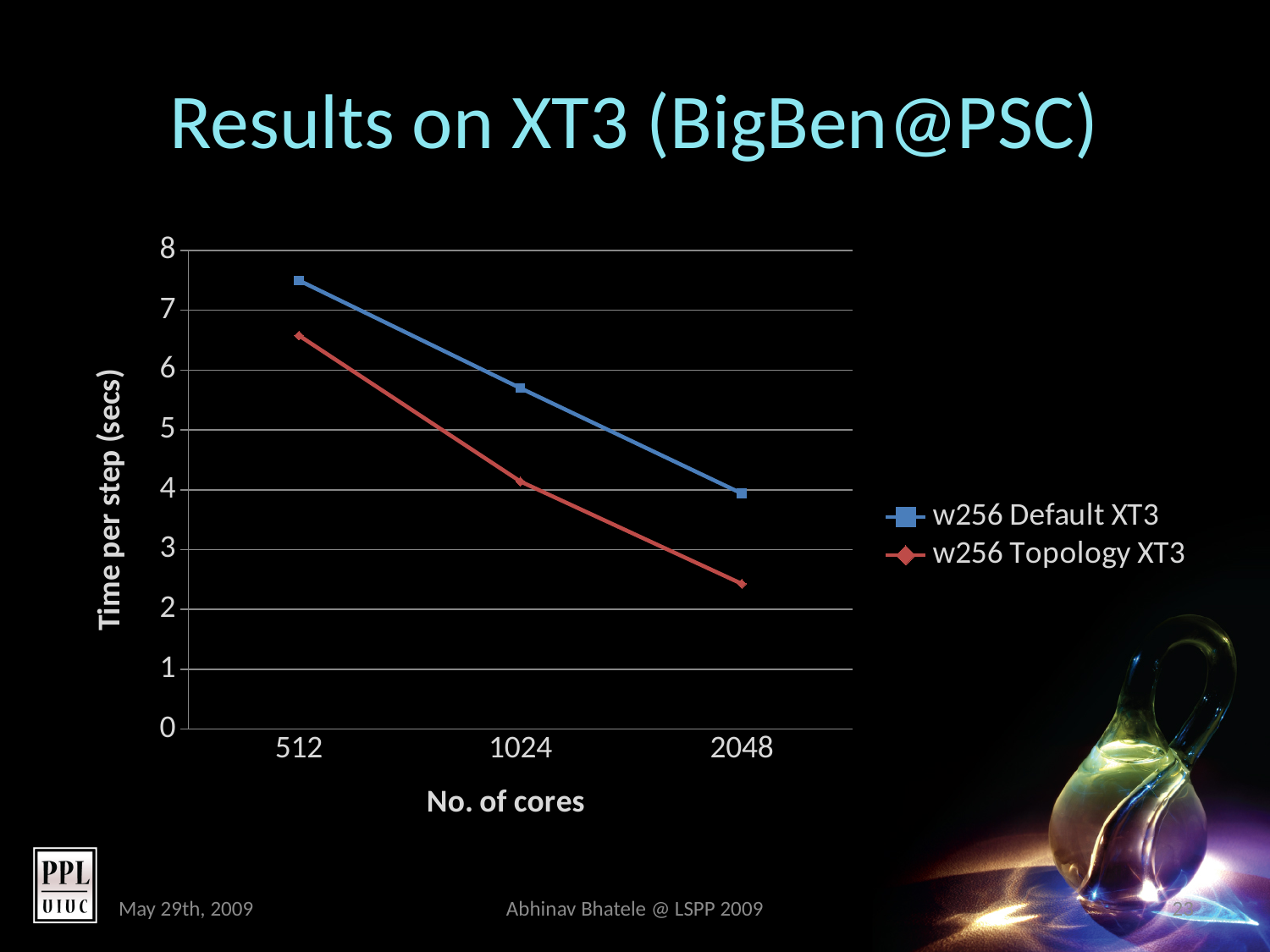
Is the value for w256 Topology XT3 at 2048 cores greater or less than 3? less Is the value for w256 Default XT3 at 1024 cores greater or less than 5? greater Is the value for w256 Default XT3 at 512 cores greater or less than 7? greater Does the time per step for w256 Topology XT3 rise or fall as the number of cores increases? fall Does the time per step for w256 Default XT3 rise or fall as the number of cores increases? fall How many core counts are plotted along the x axis? 3 At 1024 cores, which series has the higher time per step, w256 Default XT3 or w256 Topology XT3? w256 Default XT3 Which colour is used for the w256 Topology XT3 series? red What kind of chart is shown on the slide? line chart What is the label of the y axis? Time per step (secs) How many series does the legend list? 2